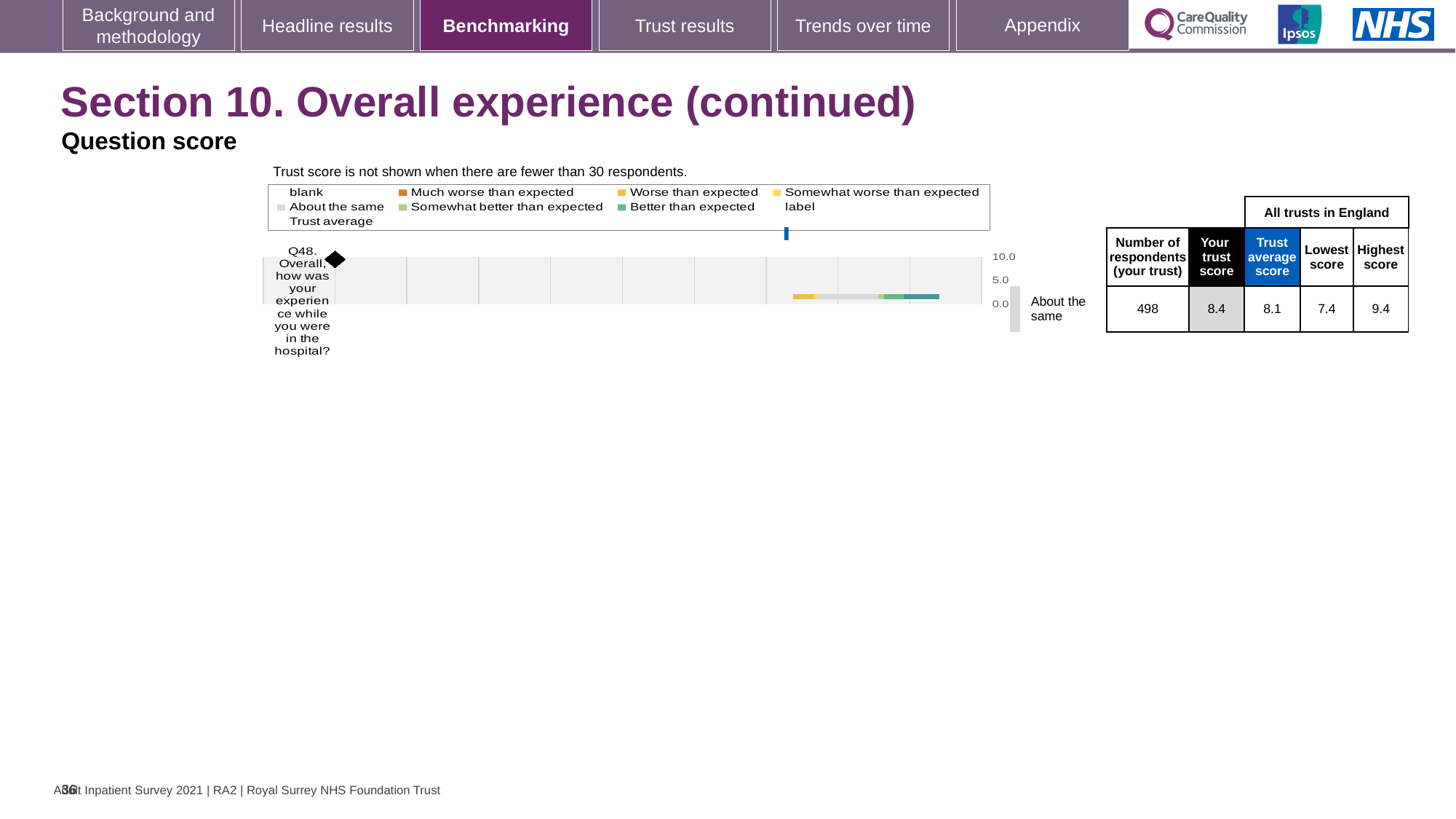
What benchmarking category is the trust's Q48 result placed in? About the same Which is larger for Q48, the trust score or the trust average score? the trust score What is the trust score for Q48 shown next to the chart? 8.4 What kind of chart is used to show the benchmarking result for Q48? bar chart What is the trust average score for Q48? 8.1 What is the difference between the highest and lowest scores for Q48 across all trusts in England? 2.0 What is the lowest score among all trusts in England for Q48? 7.4 What is the highest score among all trusts in England for Q48? 9.4 Which question is plotted in the chart? Q48. Overall, how was your experience while you were in the hospital? How many respondents from the trust answered Q48? 498 How many survey questions are plotted in the chart? 1 Is the trust score for Q48 greater or less than 5.0 on the chart's axis? greater